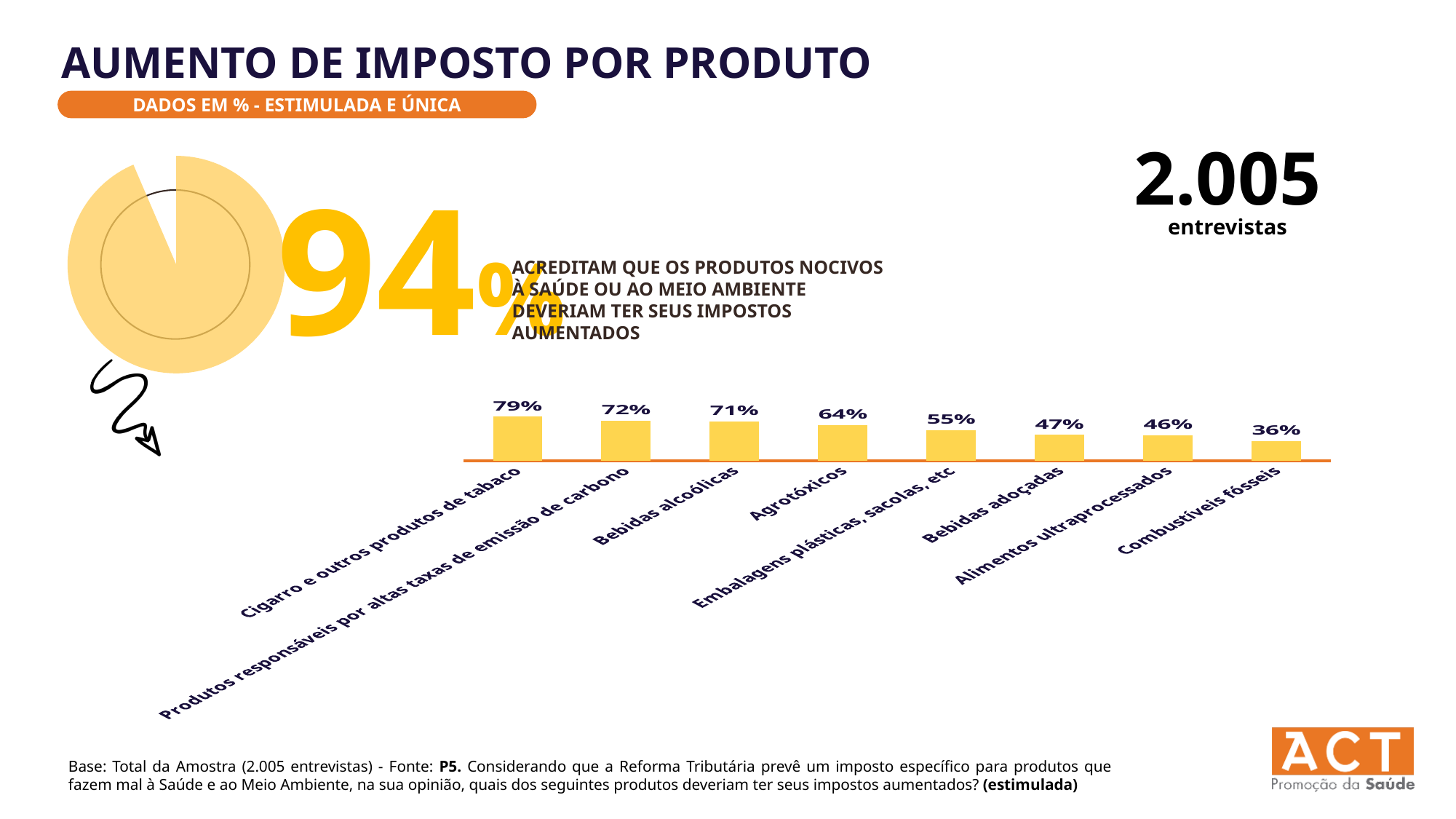
In the bar chart, what is the value for Combustíveis fósseis? 36% In the bar chart, what is the difference between the values for Bebidas alcoólicas and Embalagens plásticas, sacolas, etc? 16% How many categories does the bar chart show? 8 In the bar chart, what is the value for Bebidas adoçadas? 47% In the bar chart, which category has the lowest value? Combustíveis fósseis In the bar chart, do the values rise or fall from left to right? Fall In the bar chart, what is the value for Agrotóxicos? 64% What kind of chart is the chart at the bottom of the slide? Bar chart In the bar chart, which category has the highest value? Cigarro e outros produtos de tabaco What percentage is shown next to the pie graphic on the left of the slide? 94% In the bar chart, what is the value for Cigarro e outros produtos de tabaco? 79% In the bar chart, which is larger: the value for Produtos responsáveis por altas taxas de emissão de carbono or the value for Alimentos ultraprocessados? Produtos responsáveis por altas taxas de emissão de carbono